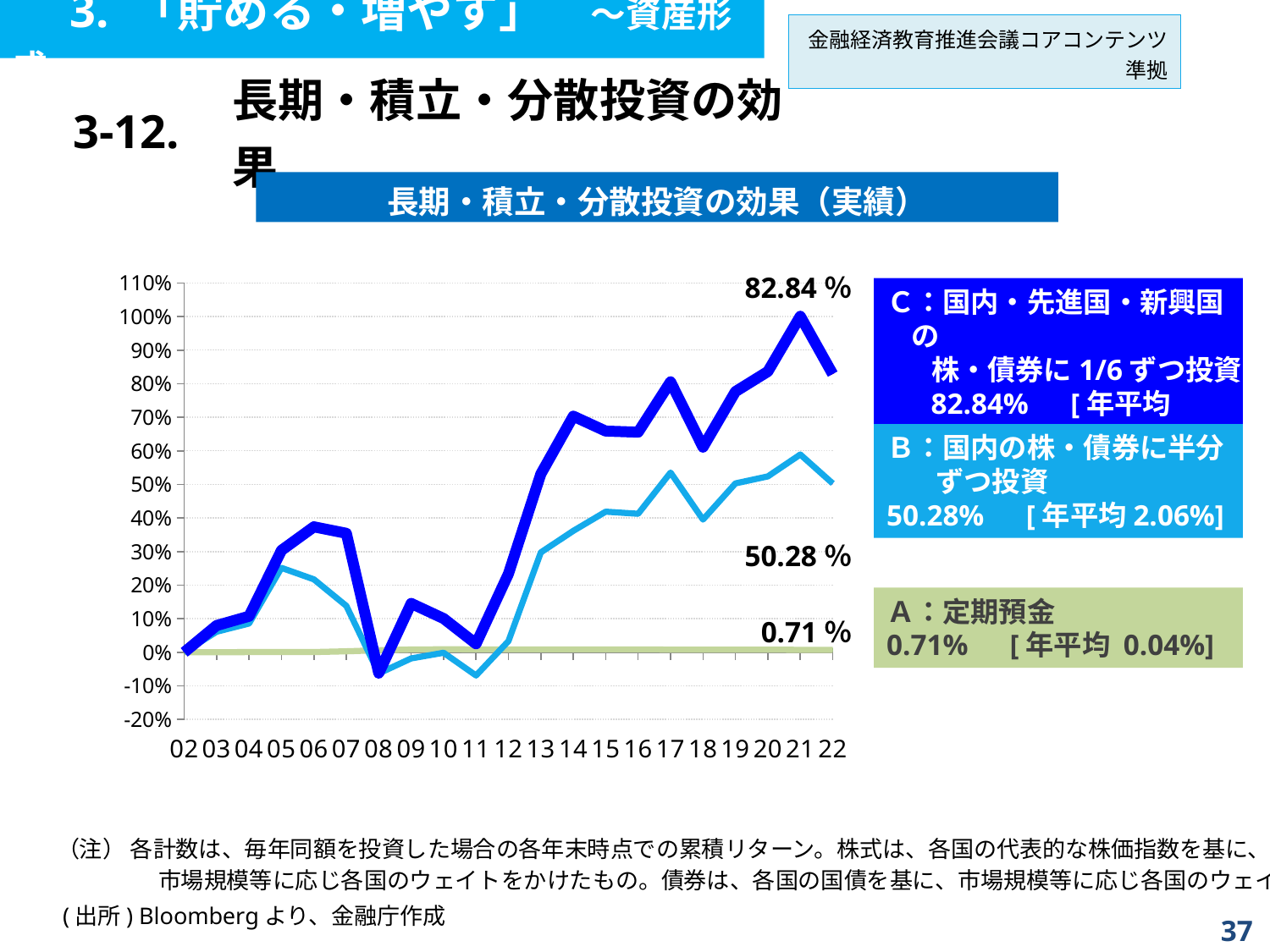
What kind of chart is shown on the slide? line chart Which series has the lowest final value on the chart? A：定期預金 What is the difference between the final values of series C (82.84%) and series B (50.28%)? 32.56% Does the dark blue line for series C overall rise or fall from 02 to 22? rise Which series has the highest final value on the chart? C：国内・先進国・新興国の株・債券に1/6ずつ投資 What is the final cumulative return labeled for series A (定期預金)? 0.71% What is the annual average return shown for series B in the legend box? 2.06% What is the final cumulative return labeled for series C (国内・先進国・新興国の株・債券に1/6ずつ投資)? 82.84% What is the final cumulative return labeled for series B (国内の株・債券に半分ずつ投資)? 50.28% How many series are plotted on the chart? 3 Is the value for series C in 2021 greater or less than 90%? greater How many years are shown on the x axis of the chart? 21